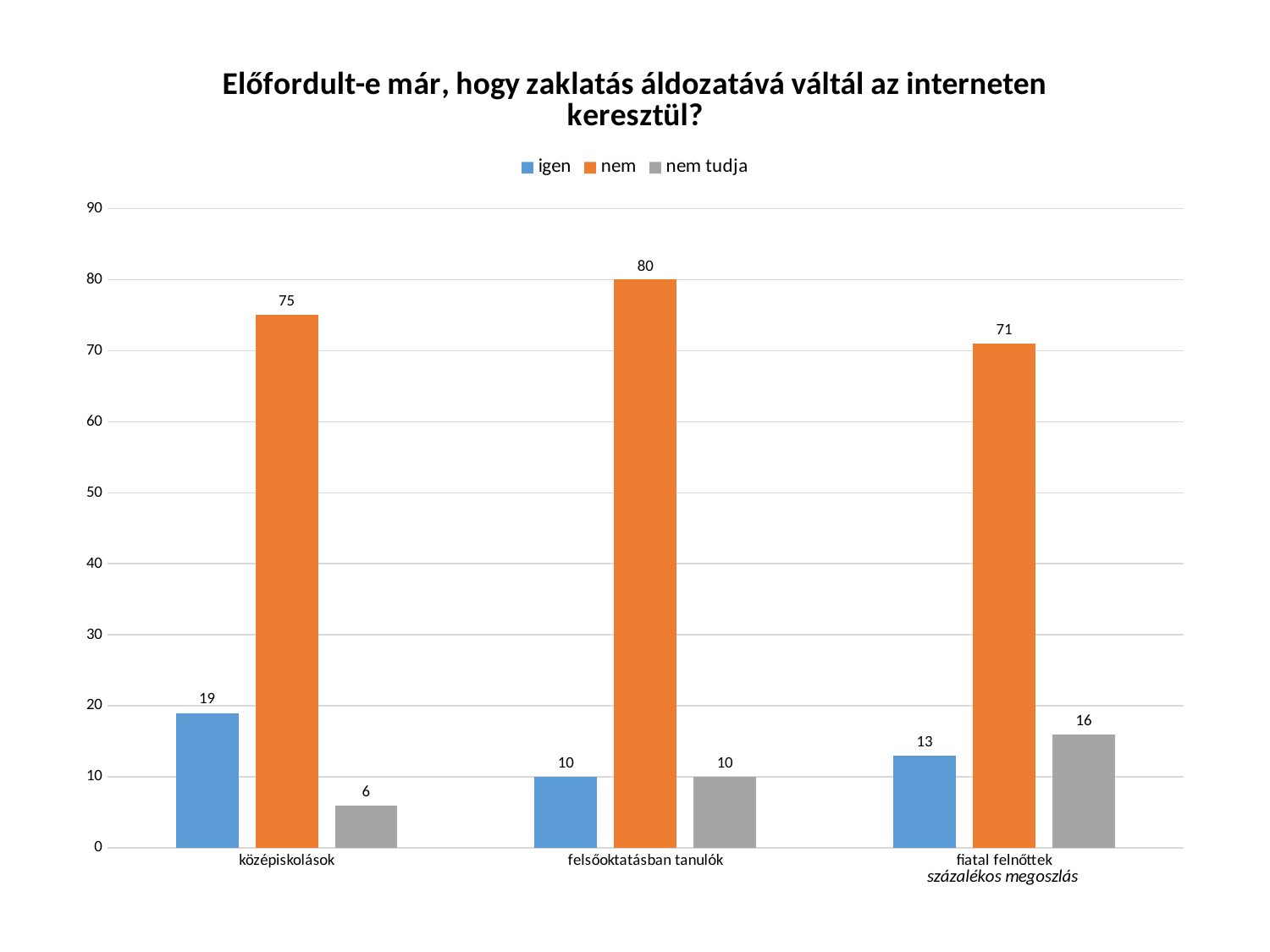
Which is larger: the "igen" value for "középiskolások" or the "igen" value for "fiatal felnőttek"? középiskolások Is the value for "nem" in the "fiatal felnőttek" category greater or less than 60? greater What kind of chart is shown on the slide? bar chart Which category has the lowest value for "nem tudja"? középiskolások What is the value for "nem" in the "középiskolások" category? 75 What is the value for "nem tudja" in the "felsőoktatásban tanulók" category? 10 What is the value for "igen" in the "fiatal felnőttek" category? 13 How many series does the legend list? 3 Which category has the highest value for "nem"? felsőoktatásban tanulók What is the difference between the "nem" values for "felsőoktatásban tanulók" and "fiatal felnőttek"? 9 How many categories are shown on the x axis? 3 What colour are the bars for the "nem" series? orange